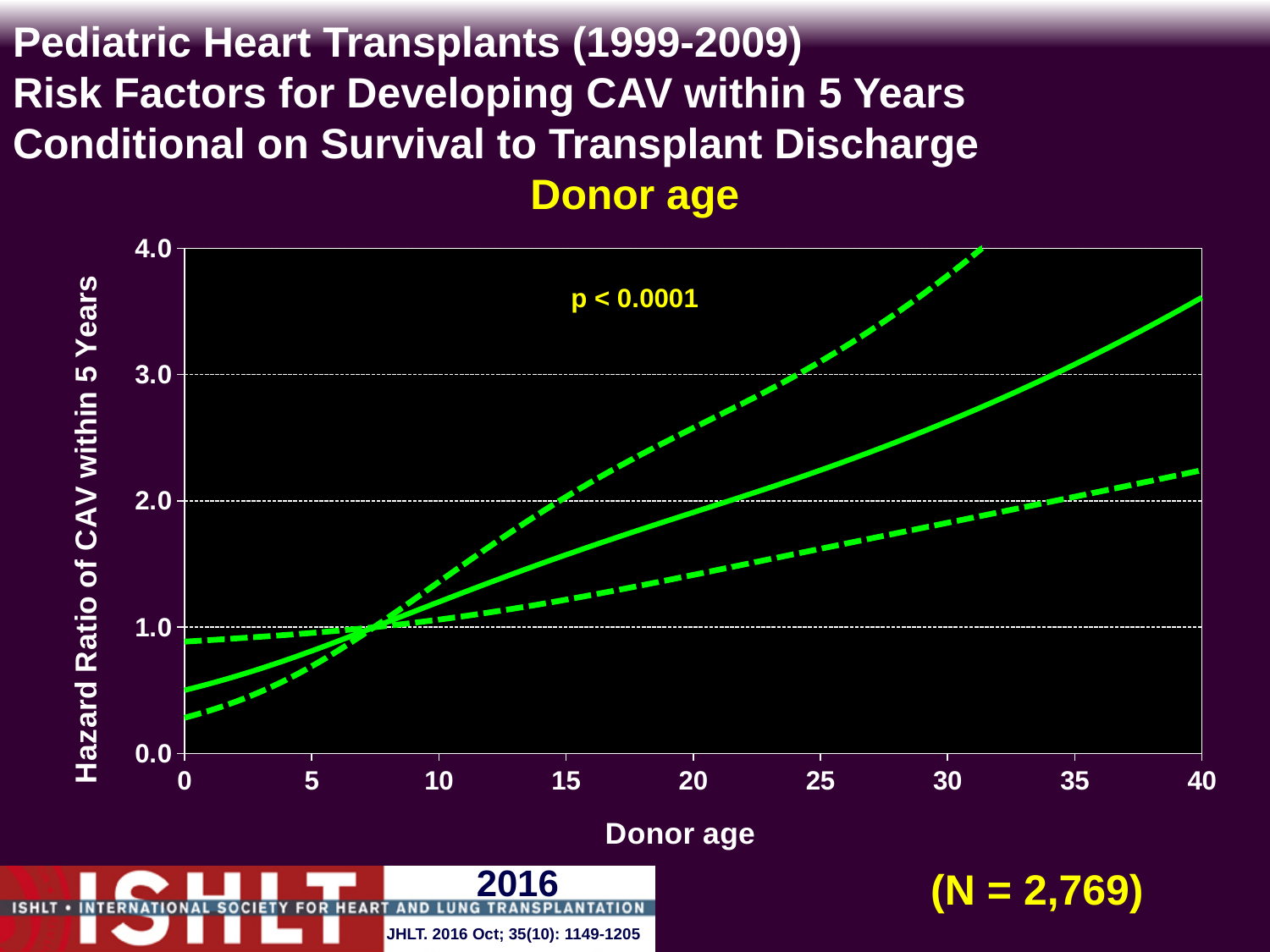
Is the hazard ratio on the solid line at donor age 40 greater or less than 3.0? greater How many lines are plotted on the chart? 3 Is the hazard ratio on the solid line at donor age 10 greater or less than 1.0? greater What p-value is printed on the chart? p < 0.0001 Does the solid line for hazard ratio rise or fall as donor age increases along the x axis? rise Is the lower dashed line at donor age 20 greater or less than 2.0? less What is the highest donor age shown on the x axis? 40 What is the highest value shown on the y axis? 4.0 What is the label of the x axis? Donor age What kind of chart is shown on the slide? line chart